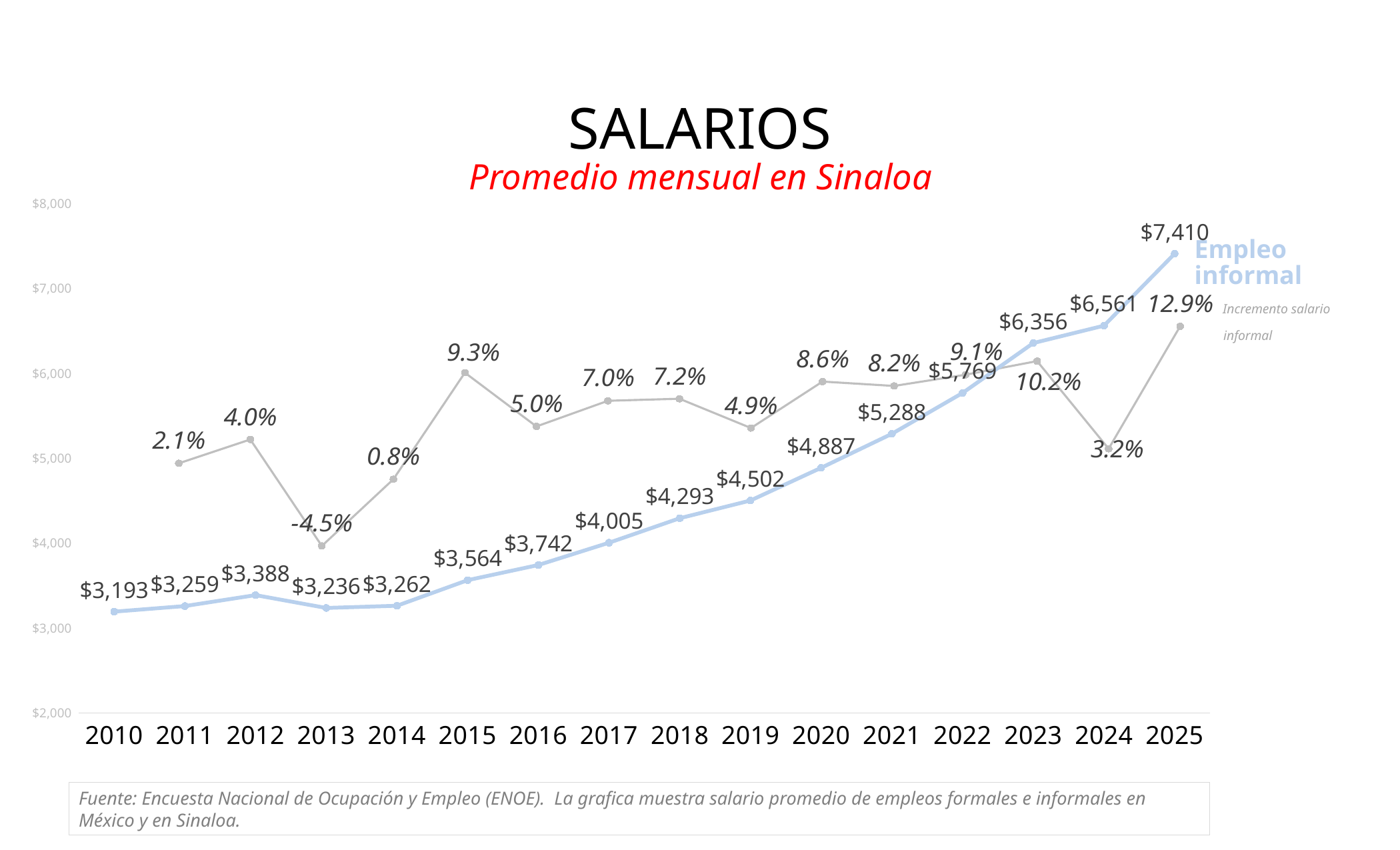
Which is larger, the Empleo informal salary in 2012 or in 2013? 2012 What is the Empleo informal salary value for 2010? $3,193 What is the difference between the Empleo informal salary in 2025 and in 2024? $849 What kind of chart is shown on the slide? Line chart How many years are shown on the x axis? 16 What is the Incremento salario informal percentage for 2023? 10.2% What is the Incremento salario informal percentage for 2013? -4.5% In which year is the Incremento salario informal percentage lowest? 2013 In which year is the Incremento salario informal percentage highest? 2025 What is the red subtitle of the chart? Promedio mensual en Sinaloa How many series does the chart show? 2 What is the Empleo informal salary value for 2025? $7,410